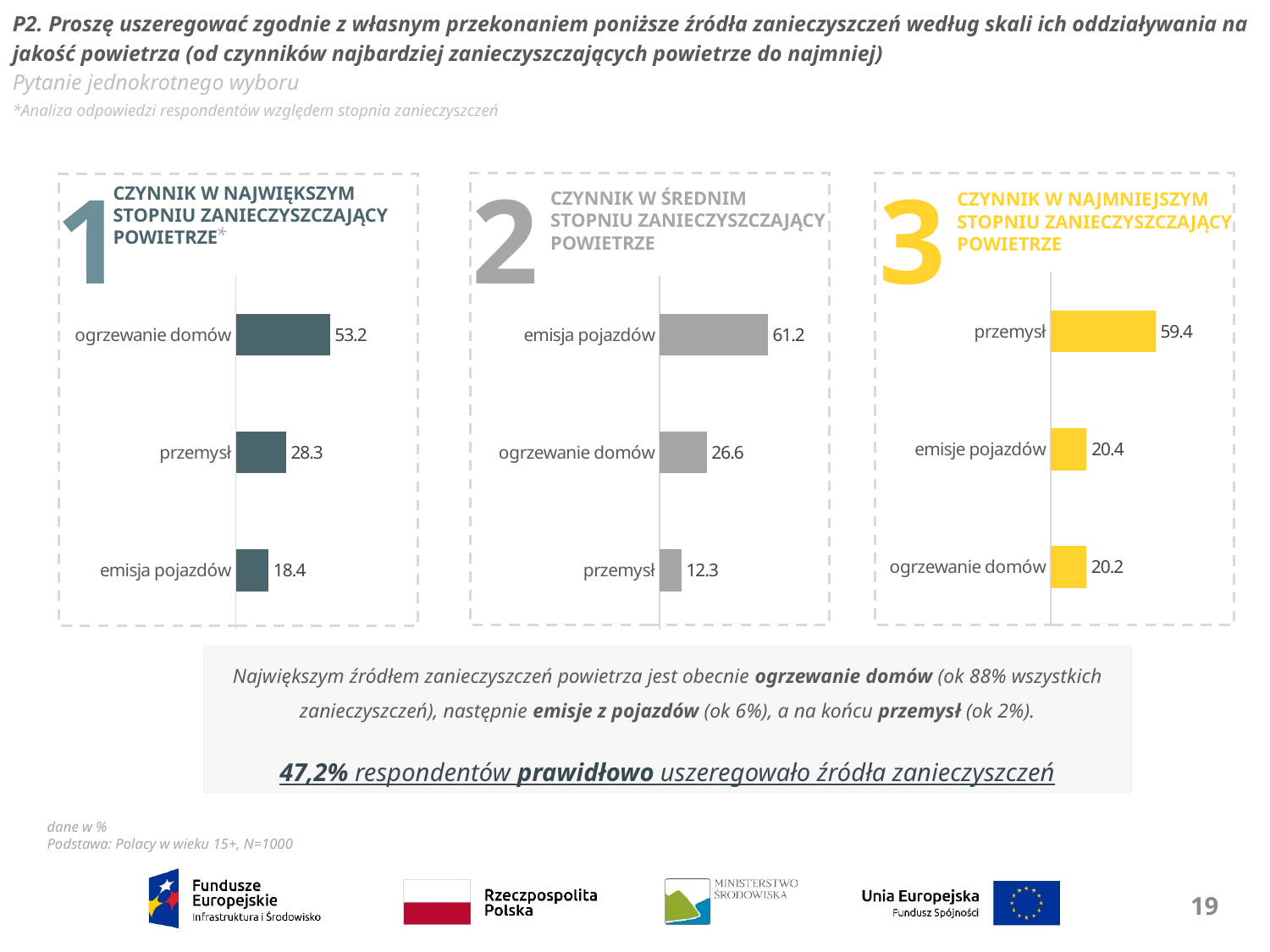
In the left chart (Czynnik w największym stopniu zanieczyszczający powietrze), what is the value for ogrzewanie domów? 53.2 What type of chart is the left chart (Czynnik w największym stopniu zanieczyszczający powietrze)? bar chart In the left chart (Czynnik w największym stopniu zanieczyszczający powietrze), which category has the lowest value? emisja pojazdów In the middle chart (Czynnik w średnim stopniu zanieczyszczający powietrze), which is larger: ogrzewanie domów or przemysł? ogrzewanie domów In the middle chart (Czynnik w średnim stopniu zanieczyszczający powietrze), which category has the highest value? emisja pojazdów In the right chart (Czynnik w najmniejszym stopniu zanieczyszczający powietrze), what is the difference between emisje pojazdów and ogrzewanie domów? 0.2 In the middle chart (Czynnik w średnim stopniu zanieczyszczający powietrze), what is the value for emisja pojazdów? 61.2 What colour are the bars in the right chart (Czynnik w najmniejszym stopniu zanieczyszczający powietrze)? yellow In the left chart (Czynnik w największym stopniu zanieczyszczający powietrze), what is the difference between ogrzewanie domów and przemysł? 24.9 In the middle chart (Czynnik w średnim stopniu zanieczyszczający powietrze), what is the difference between emisja pojazdów and przemysł? 48.9 In the right chart (Czynnik w najmniejszym stopniu zanieczyszczający powietrze), what is the value for przemysł? 59.4 How many categories are shown in the right chart (Czynnik w najmniejszym stopniu zanieczyszczający powietrze)? 3